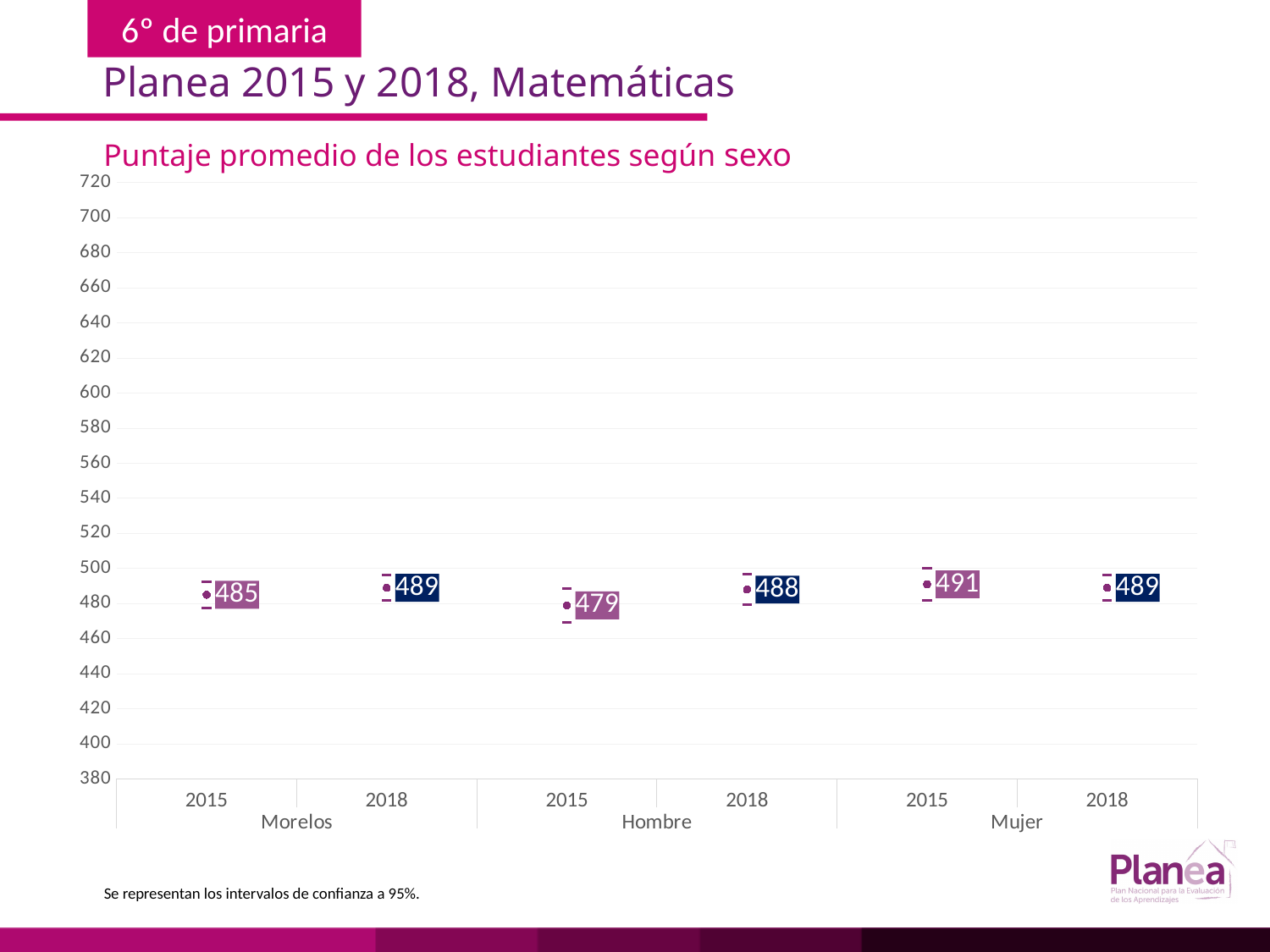
Did the Mujer average score rise or fall from 2015 to 2018? fall What is the average score for Morelos in 2018? 489 How many data points are plotted on the chart? 6 What is the difference between the Mujer score in 2015 and the Hombre score in 2015? 12 What is the average score for Mujer in 2015? 491 Which group and year has the lowest average score? Hombre 2015 What is the title of the chart? Puntaje promedio de los estudiantes según sexo Which is larger, the Mujer score in 2018 or the Hombre score in 2018? Mujer 2018 What is the average score for Hombre in 2018? 488 What is the difference between the Hombre scores in 2018 and 2015? 9 Which group and year has the highest average score? Mujer 2015 What is the average score for Morelos in 2015? 485